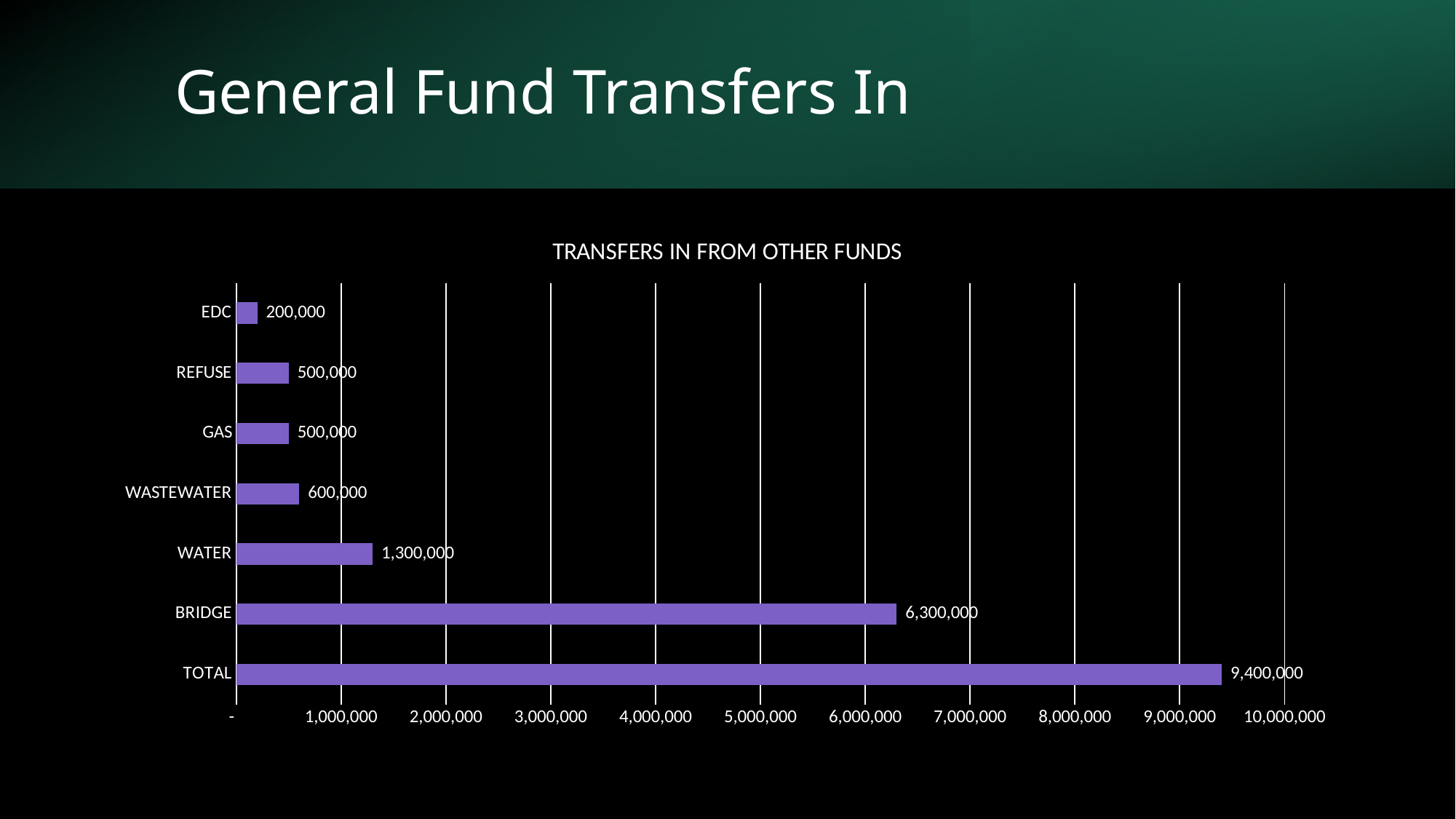
What kind of chart is shown? Bar chart What is the value for WASTEWATER? 600,000 Which category has the lowest value? EDC Excluding TOTAL, which category has the highest value? BRIDGE What is the value for WATER? 1,300,000 What is the difference between the values for BRIDGE and WATER? 5,000,000 What is the value for EDC? 200,000 What is the value for BRIDGE? 6,300,000 How many categories are shown on the chart? 7 Which is larger, the value for WASTEWATER or the value for GAS? WASTEWATER What is the title of the chart? TRANSFERS IN FROM OTHER FUNDS What is the value for TOTAL? 9,400,000